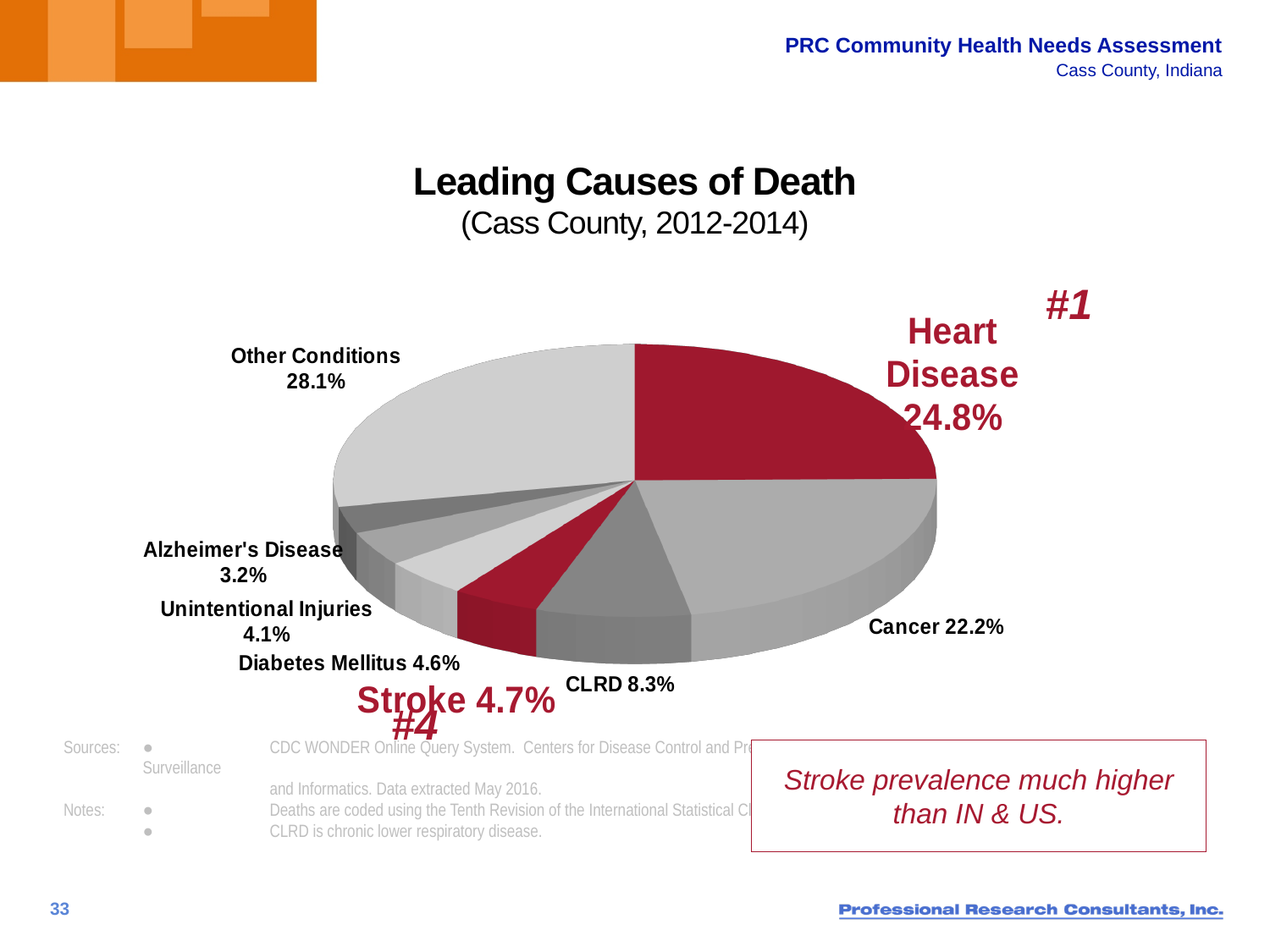
Which is larger, the share for Diabetes Mellitus or the share for Unintentional Injuries? Diabetes Mellitus What percentage of deaths is attributed to Heart Disease? 24.8% What is the value shown for CLRD? 8.3% What is the value shown for Stroke? 4.7% What kind of chart is shown on the slide? pie chart What is the title of the chart? Leading Causes of Death (Cass County, 2012-2014) Which slice of the pie is the smallest? Alzheimer's Disease What is the difference between the Heart Disease and Cancer percentages? 2.6% What percentage of deaths is attributed to Cancer? 22.2% Which slice of the pie is the largest? Other Conditions How many slices does the pie chart have? 8 What is the value shown for Alzheimer's Disease? 3.2%